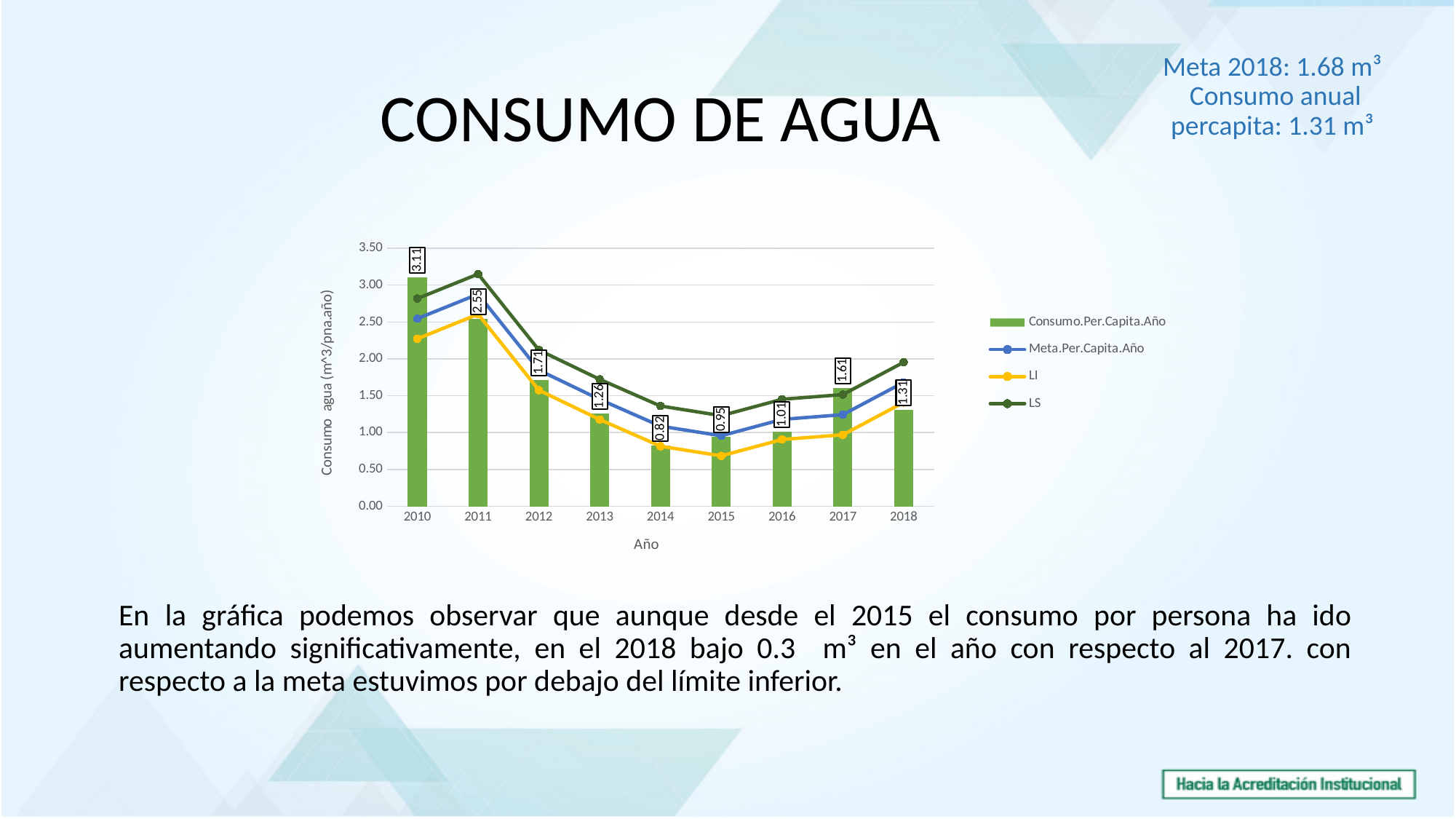
Is the LS value for 2010 greater or less than 2.50? greater How many years are shown on the x axis of the chart? 9 Which year has a larger Consumo.Per.Capita.Año value, 2015 or 2016? 2016 What is the value of Consumo.Per.Capita.Año for 2010? 3.11 How many series does the chart legend list? 4 What is the difference between the Consumo.Per.Capita.Año values for 2017 and 2018? 0.30 Do the Consumo.Per.Capita.Año values rise or fall from 2010 to 2014? fall Which year has the highest Consumo.Per.Capita.Año bar? 2010 Which year has the lowest Consumo.Per.Capita.Año bar? 2014 What is the value of Consumo.Per.Capita.Año for 2018? 1.31 What kind of chart is shown on the slide? Combined bar and line chart What is the value of Consumo.Per.Capita.Año for 2014? 0.82